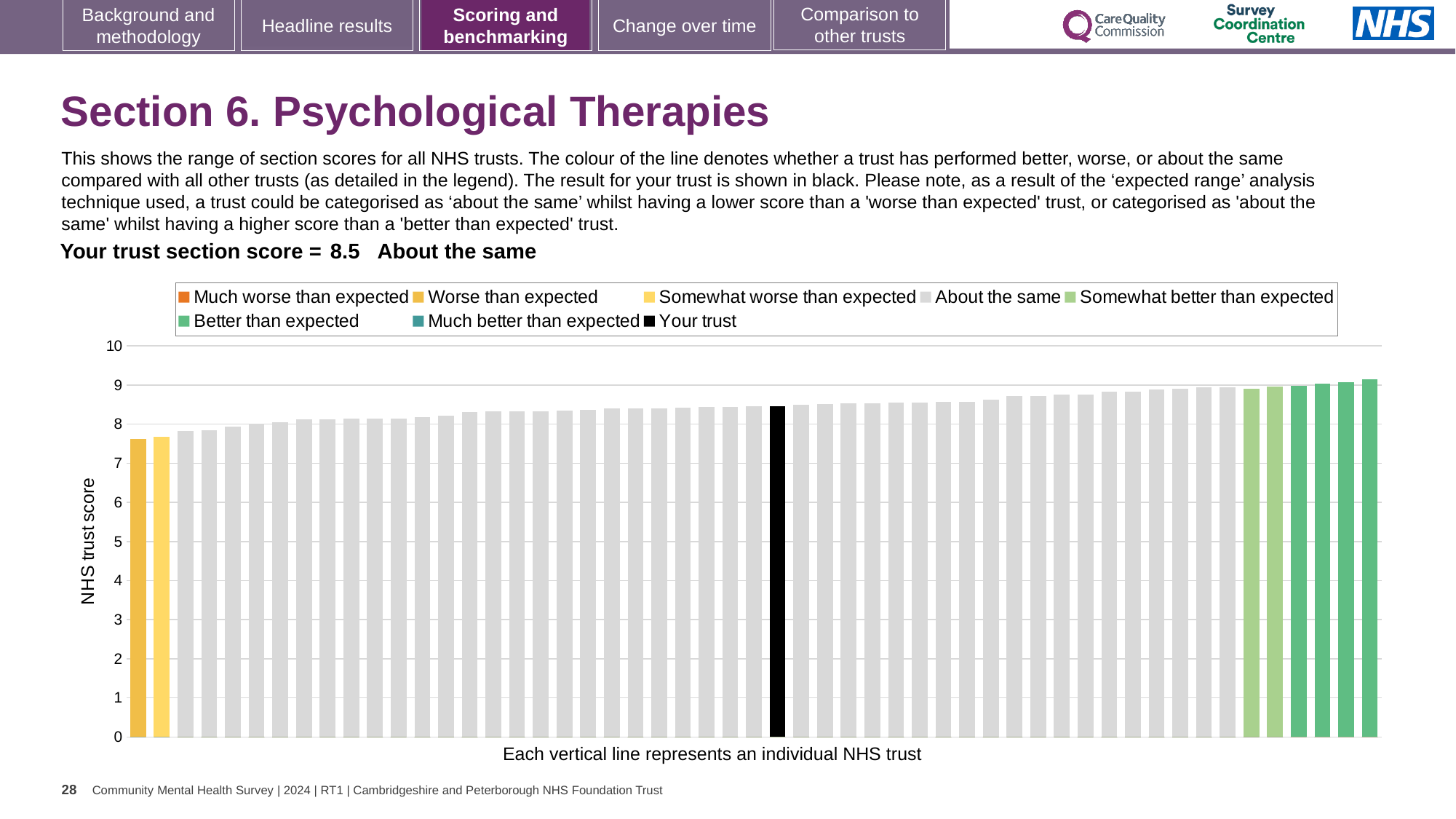
Is the score of the highest-scoring trust (rightmost bar) greater or less than 8? greater Is the score of the lowest-scoring trust (leftmost bar) greater or less than 8? less What kind of chart is shown on the slide? bar chart Which performance category is the trust's section score placed in? About the same What is the trust's section score for Section 6. Psychological Therapies? 8.5 Which legend category does the lowest bar on the chart belong to? Worse than expected How many entries does the chart legend list? 8 Is the trust's own section score greater or less than 8? greater Which legend category does the highest bar on the chart belong to? Better than expected What is the label on the vertical axis of the chart? NHS trust score Do the bar values rise or fall from left to right along the x axis? rise Is the trust's own score (black bar) higher or lower than the leftmost bar? higher